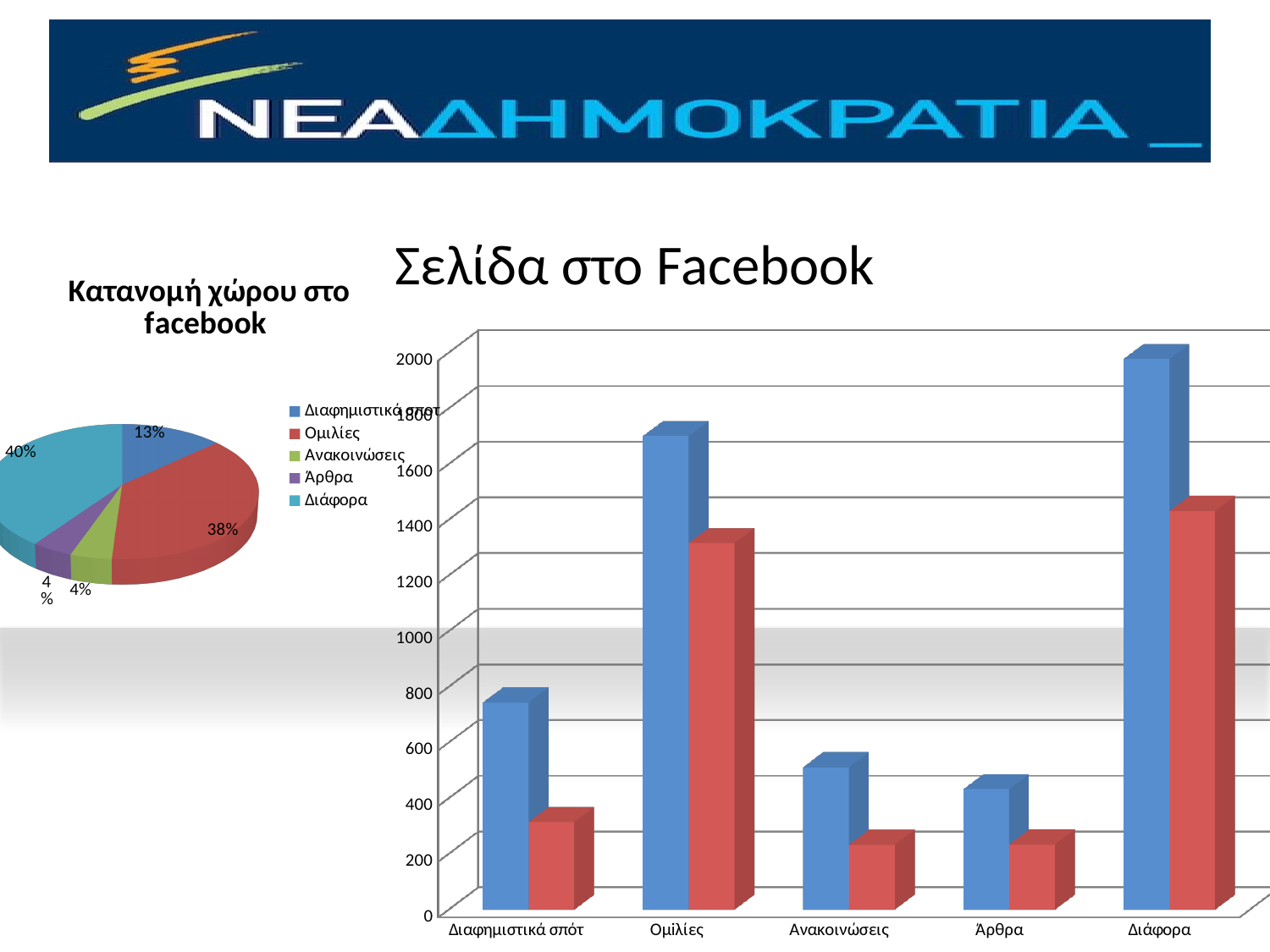
In the bar chart on the right side of the slide, is the red bar for Διαφημιστικά σποτ greater or less than 400? less In the pie chart titled 'Κατανομή χώρου στο facebook', how many entries does the legend list? 5 In the bar chart on the right side of the slide, is the blue bar for Ομιλίες greater or less than 1600? greater What kind of chart is the large chart on the right side of the slide? Bar chart In the pie chart titled 'Κατανομή χώρου στο facebook', what percentage is shown for Διάφορα? 40% In the pie chart titled 'Κατανομή χώρου στο facebook', which category has the largest slice? Διάφορα In the pie chart titled 'Κατανομή χώρου στο facebook', what percentage is shown for Διαφημιστικά σποτ? 13% What kind of chart is the chart titled 'Κατανομή χώρου στο facebook'? Pie chart In the bar chart on the right side of the slide, which category has the tallest blue bar? Διάφορα In the pie chart titled 'Κατανομή χώρου στο facebook', what percentage is shown for Ομιλίες? 38% In the bar chart on the right side of the slide, how many categories are shown on the x axis? 5 In the bar chart on the right side of the slide, which category has the shortest blue bar? Άρθρα